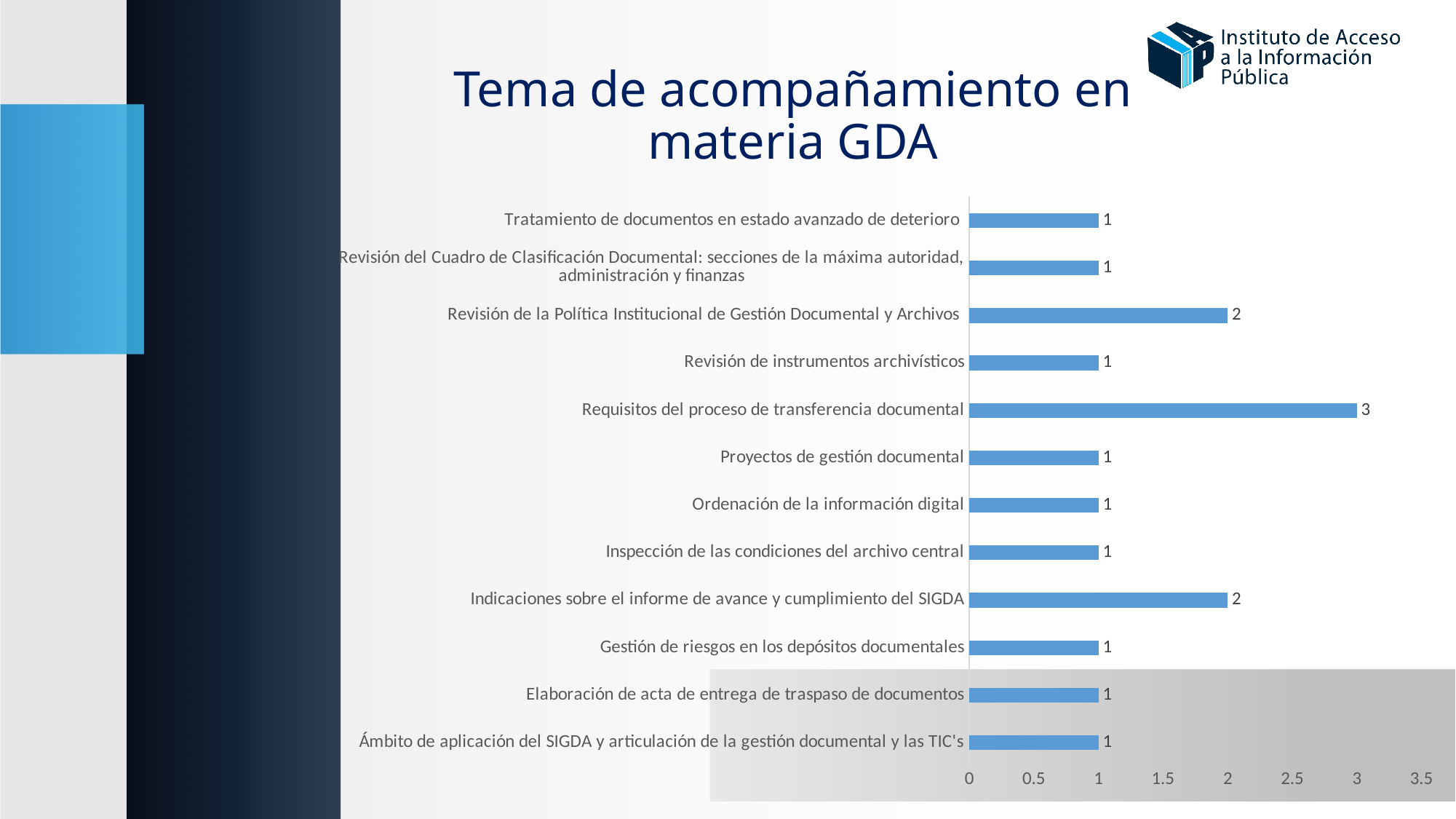
What is the value for Indicaciones sobre el informe de avance y cumplimiento del SIGDA? 2 Which is larger: the value for Revisión de la Política Institucional de Gestión Documental y Archivos or the value for Revisión de instrumentos archivísticos? Revisión de la Política Institucional de Gestión Documental y Archivos What is the value for Requisitos del proceso de transferencia documental? 3 What is the value for Gestión de riesgos en los depósitos documentales? 1 Which category has the highest value? Requisitos del proceso de transferencia documental What is the difference between the values for Requisitos del proceso de transferencia documental and Proyectos de gestión documental? 2 How many categories have a value of 2? 2 What is the title of the slide? Tema de acompañamiento en materia GDA What is the value for Revisión de la Política Institucional de Gestión Documental y Archivos? 2 How many categories are shown in the chart? 12 Is the value for Requisitos del proceso de transferencia documental greater or less than 2.5? greater What kind of chart is shown on the slide? bar chart